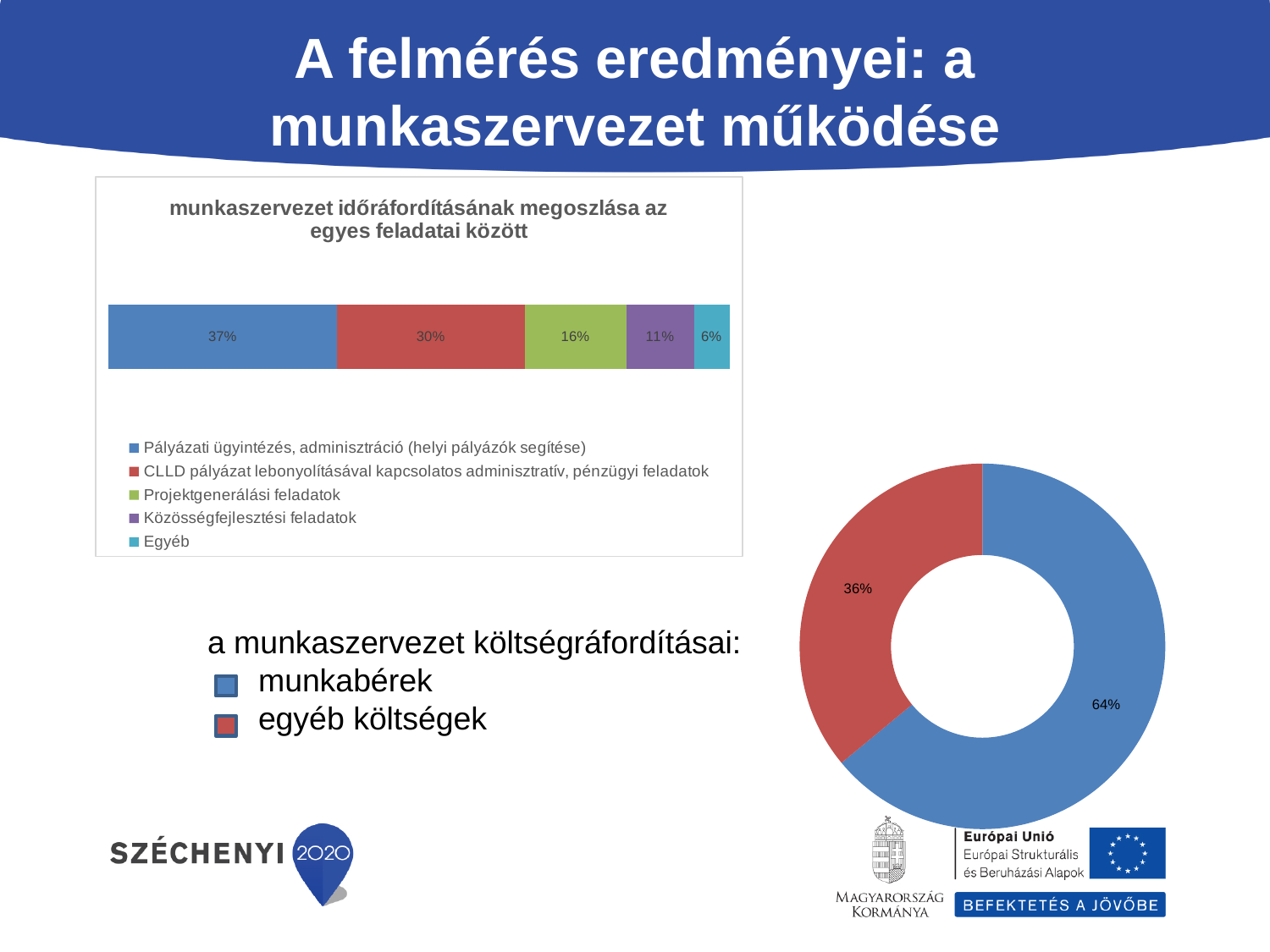
In the doughnut chart on the right, what share is shown for "egyéb költségek"? 36% How many series does the legend of the stacked bar chart on the left list? 5 In the stacked bar chart on the left, which task has the largest share of time? Pályázati ügyintézés, adminisztráció (helyi pályázók segítése) In the stacked bar chart titled "munkaszervezet időráfordításának megoszlása az egyes feladatai között", what share is shown for "Pályázati ügyintézés, adminisztráció (helyi pályázók segítése)"? 37% In the stacked bar chart on the left, what share is shown for "Projektgenerálási feladatok"? 16% In the stacked bar chart on the left, which task has the smallest share of time? Egyéb In the stacked bar chart on the left, what is the difference between the shares for "CLLD pályázat lebonyolításával kapcsolatos adminisztratív, pénzügyi feladatok" and "Közösségfejlesztési feladatok"? 19 percentage points In the stacked bar chart on the left, which is larger: the share for "Projektgenerálási feladatok" or for "Közösségfejlesztési feladatok"? Projektgenerálási feladatok What kind of chart is the chart on the right of the slide? Doughnut chart In the doughnut chart on the right (a munkaszervezet költségráfordításai), what share is shown for "munkabérek"? 64% What kind of chart is the chart on the left of the slide? Stacked bar chart In the stacked bar chart on the left, what share is shown for "Egyéb"? 6%